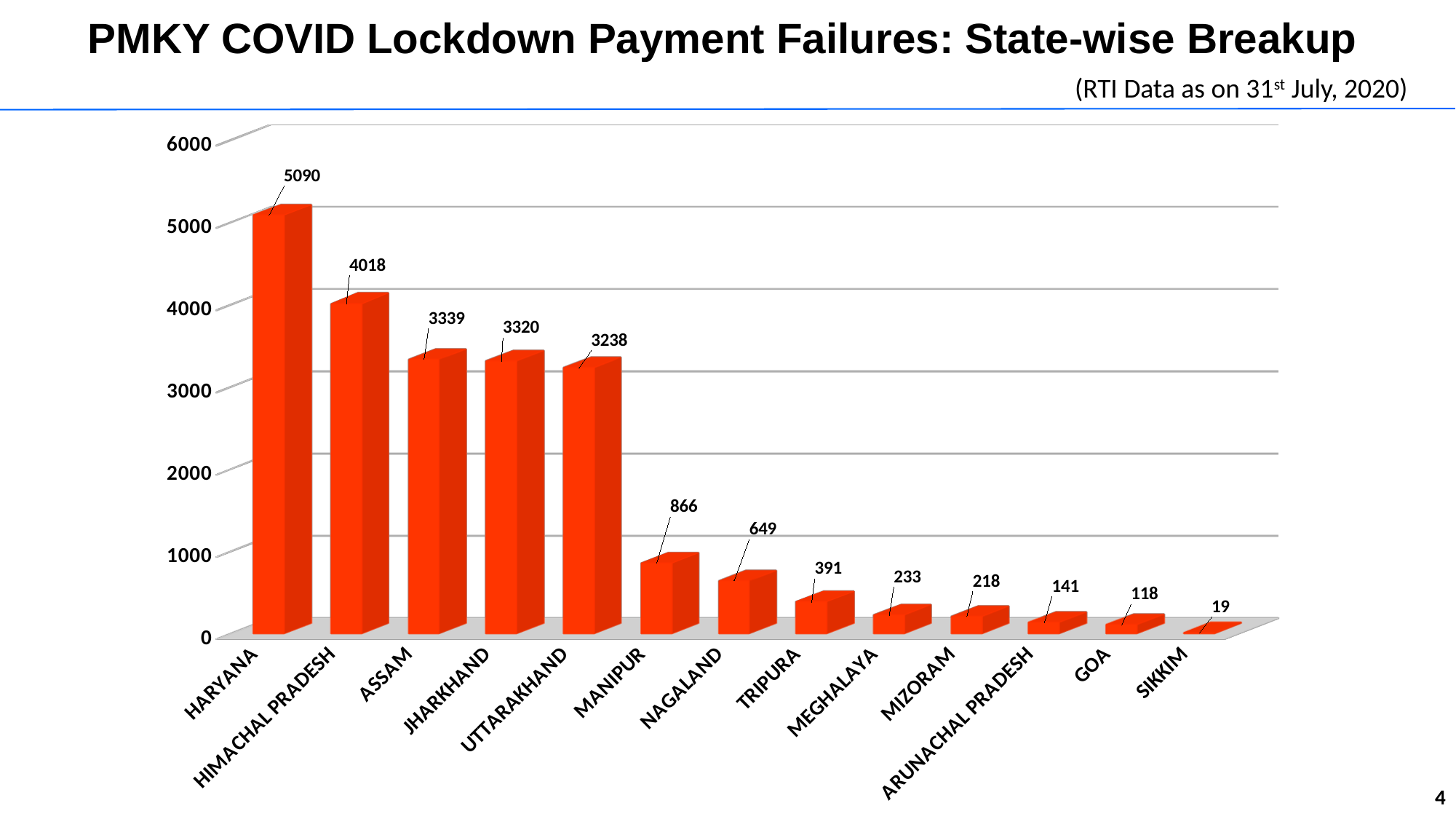
What is the difference between the values for Manipur and Nagaland? 217 What is the value for Arunachal Pradesh? 141 Which state has the lowest value? Sikkim What is the difference between the values for Haryana and Himachal Pradesh? 1072 How many states are shown on the chart? 13 Which is larger, the value for Assam or the value for Uttarakhand? Assam Is the value for Manipur greater or less than 1000? less Which state has the highest value? Haryana What is the title of the slide? PMKY COVID Lockdown Payment Failures: State-wise Breakup What is the value for Haryana? 5090 What is the value for Nagaland? 649 What kind of chart is shown on the slide? bar chart